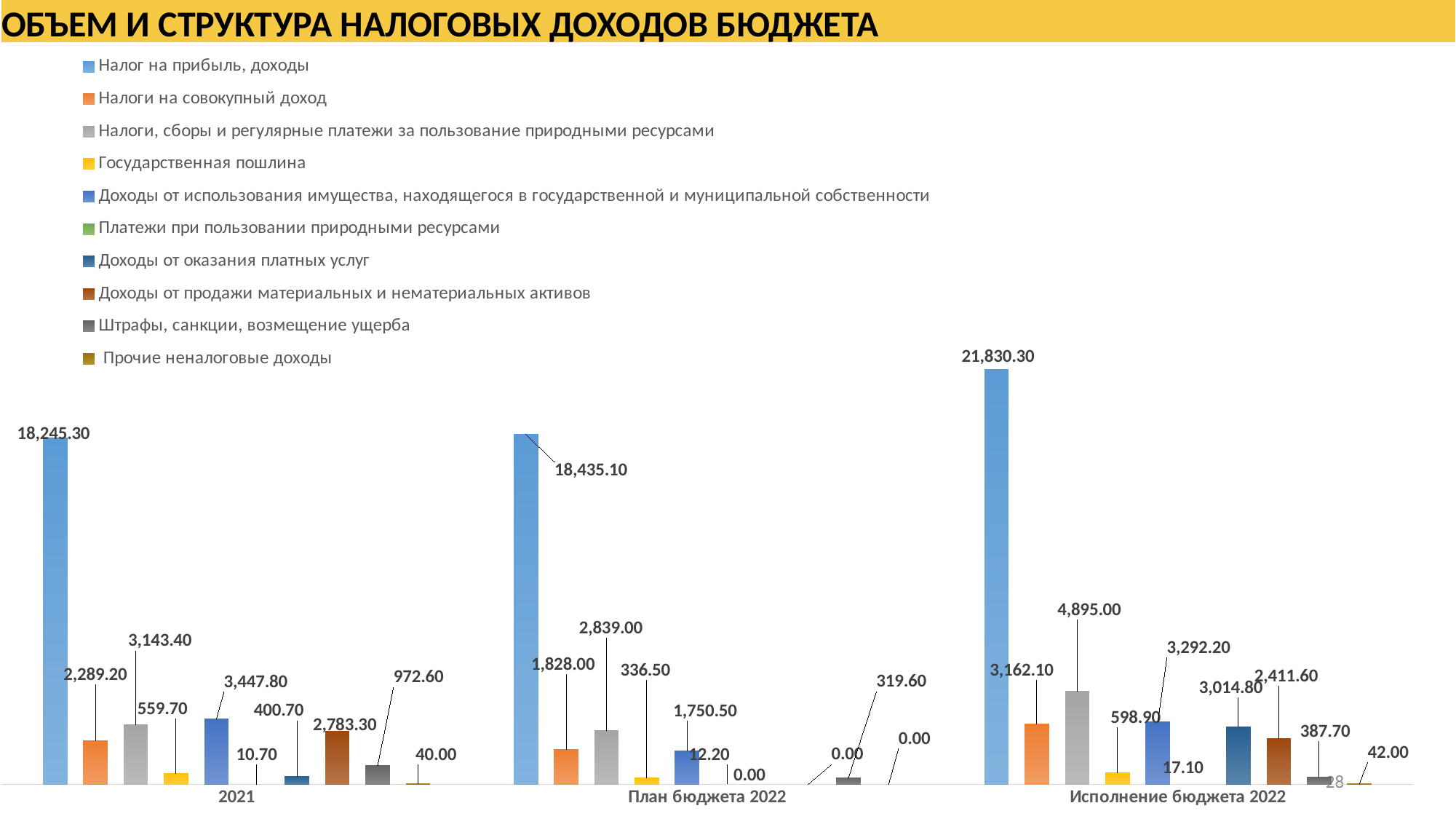
Which category has the highest value for Налог на прибыль, доходы? Исполнение бюджета 2022 What is the value of Налог на прибыль, доходы for 2021? 18,245.30 What is the difference between Налог на прибыль, доходы for Исполнение бюджета 2022 and for 2021? 3,585.00 What is the value of Налоги на совокупный доход for План бюджета 2022? 1,828.00 How many categories are shown on the x axis? 3 What is the value of Государственная пошлина for Исполнение бюджета 2022? 598.90 How many series does the legend list? 10 What kind of chart is shown on the slide? Bar chart What is the title of the slide? ОБЪЕМ И СТРУКТУРА НАЛОГОВЫХ ДОХОДОВ БЮДЖЕТА What is the value of Налог на прибыль, доходы for Исполнение бюджета 2022? 21,830.30 Which category has the lowest value for Налоги на совокупный доход? План бюджета 2022 Which is larger: Налоги на совокупный доход for 2021 or for Исполнение бюджета 2022? Исполнение бюджета 2022